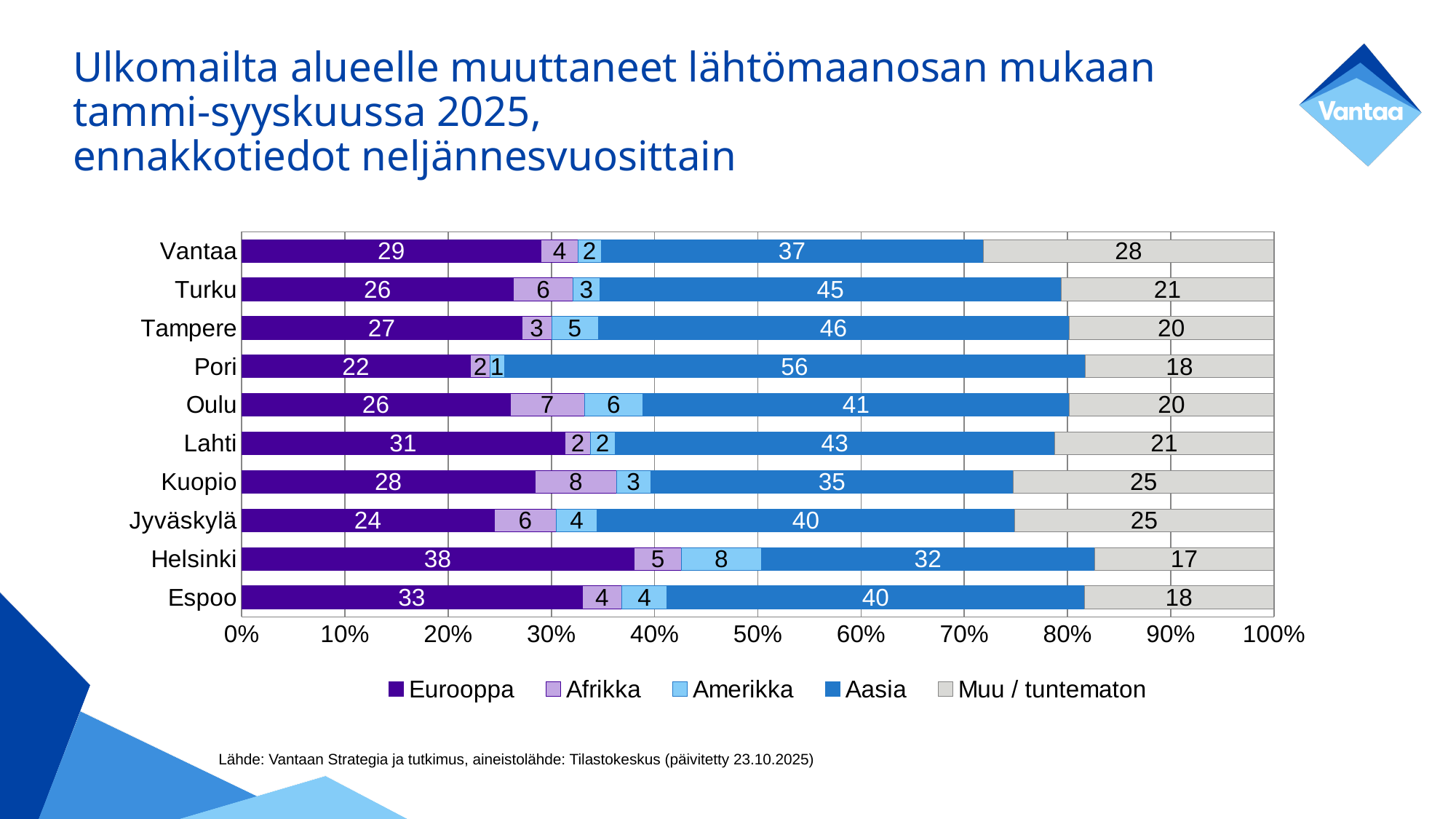
How many cities are shown on the chart? 10 What is the value for Aasia for Vantaa? 37 What is the value for Muu / tuntematon for Kuopio? 25 Which city has the highest value for Aasia? Pori What is the total of the stacked bar for Oulu? 100 Which is larger, the Eurooppa value for Helsinki or the Eurooppa value for Espoo? Helsinki What kind of chart is shown on the slide? Stacked bar chart How many series does the legend list? 5 Which city has the lowest value for Eurooppa? Pori Which city has the highest value for Muu / tuntematon? Vantaa What is the difference between the Aasia value and the Eurooppa value for Vantaa? 8 What is the value for Eurooppa for Helsinki? 38